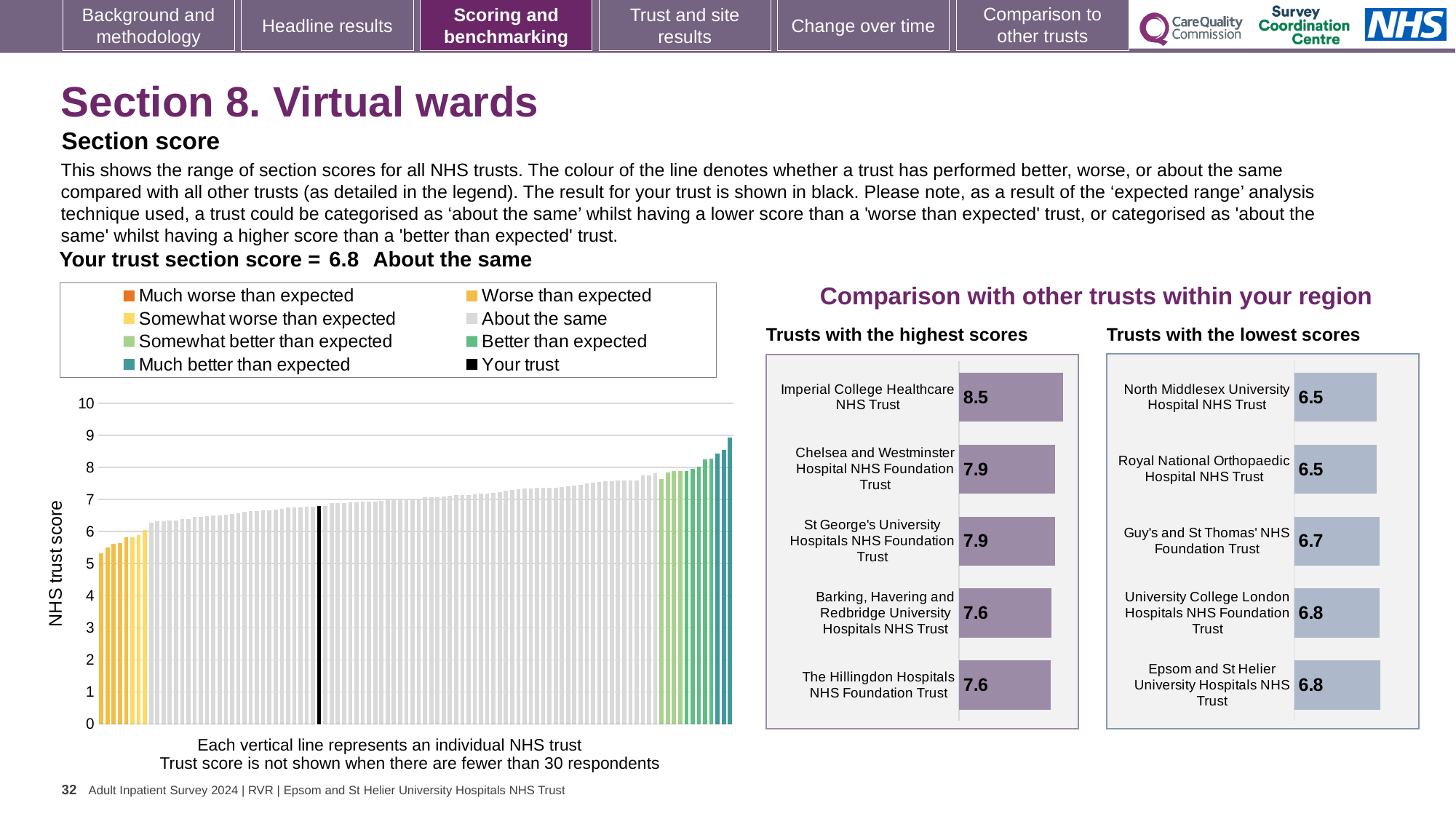
In the large chart on the left, do the bar values rise or fall from left to right? Rise In the 'Trusts with the highest scores' chart, which trust has the highest score? Imperial College Healthcare NHS Trust In the large chart on the left, what is the section score for your trust (the black bar)? 6.8 In the 'Trusts with the lowest scores' chart, what is the score for Guy's and St Thomas' NHS Foundation Trust? 6.7 In the 'Trusts with the highest scores' chart, what is the score for Barking, Havering and Redbridge University Hospitals NHS Trust? 7.6 How many entries does the legend of the large chart on the left list? 8 In the 'Trusts with the lowest scores' chart, how many trusts are shown? 5 In the 'Trusts with the lowest scores' chart, which has the larger score: Guy's and St Thomas' NHS Foundation Trust or North Middlesex University Hospital NHS Trust? Guy's and St Thomas' NHS Foundation Trust What kind of chart is the large chart on the left showing NHS trust scores? Bar chart In the 'Trusts with the highest scores' chart, what is the difference between the scores of Imperial College Healthcare NHS Trust and The Hillingdon Hospitals NHS Foundation Trust? 0.9 In the 'Trusts with the highest scores' chart, what is the score for Imperial College Healthcare NHS Trust? 8.5 In the 'Trusts with the lowest scores' chart, what is the score for Epsom and St Helier University Hospitals NHS Trust? 6.8